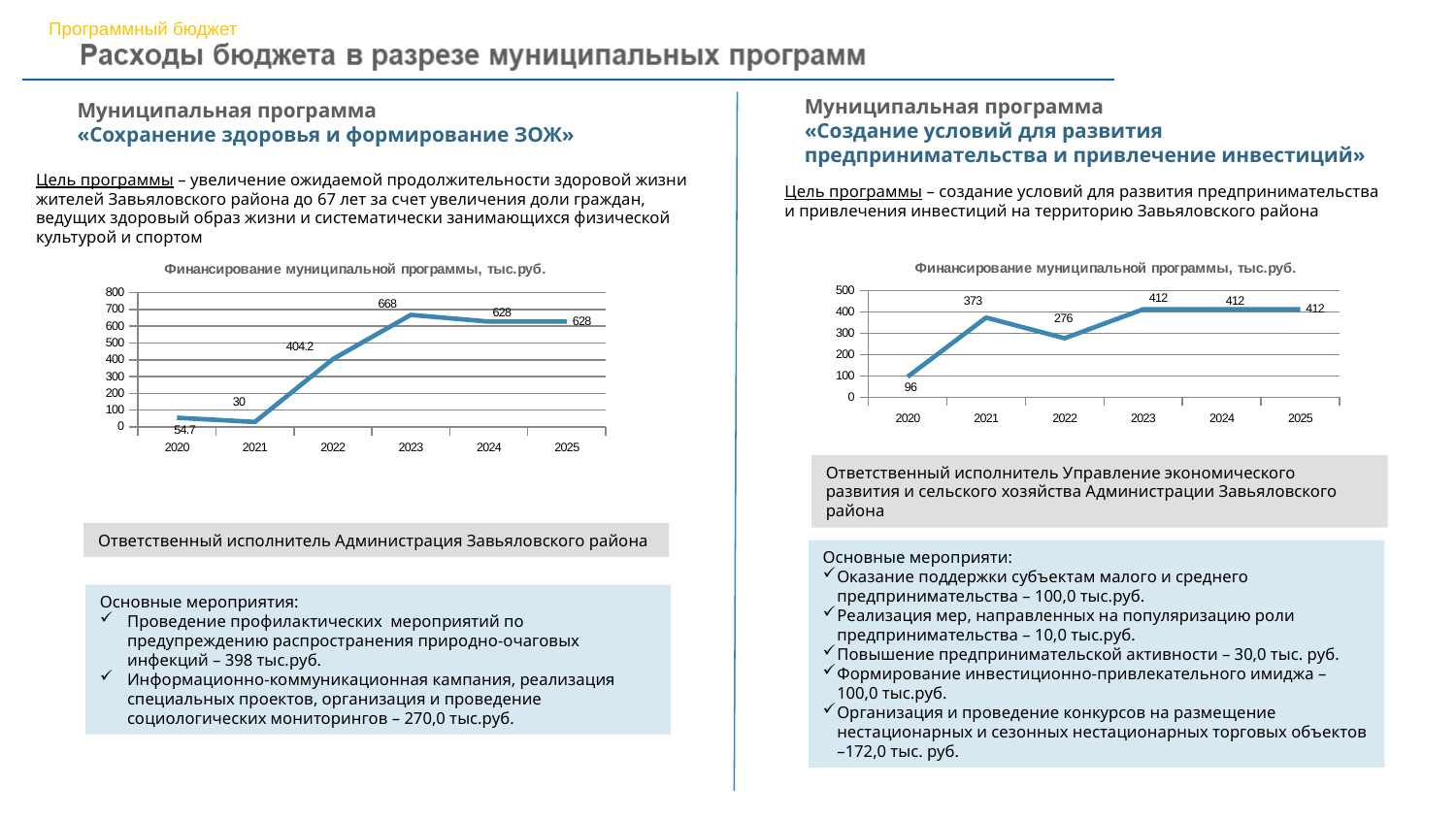
On the right chart (Создание условий для развития предпринимательства), what is the value for 2022? 276 On the left chart (Сохранение здоровья и формирование ЗОЖ), what is the value for 2023? 668 On the right chart (Создание условий для развития предпринимательства), which is larger, the value for 2021 or the value for 2022? 2021 On the right chart (Создание условий для развития предпринимательства), what is the difference between the values for 2021 and 2020? 277 On the right chart (Создание условий для развития предпринимательства), what is the value for 2020? 96 On the left chart (Сохранение здоровья и формирование ЗОЖ), which year has the lowest value? 2021 On the left chart (Сохранение здоровья и формирование ЗОЖ), which year has the highest value? 2023 On the left chart (Сохранение здоровья и формирование ЗОЖ), what is the value for 2022? 404.2 What type of chart is the right chart (Создание условий для развития предпринимательства)? Line chart On the left chart (Сохранение здоровья и формирование ЗОЖ), what is the difference between the values for 2023 and 2024? 40 What is the title of the left chart? Финансирование муниципальной программы, тыс.руб. On the left chart (Сохранение здоровья и формирование ЗОЖ), how many years are plotted? 6